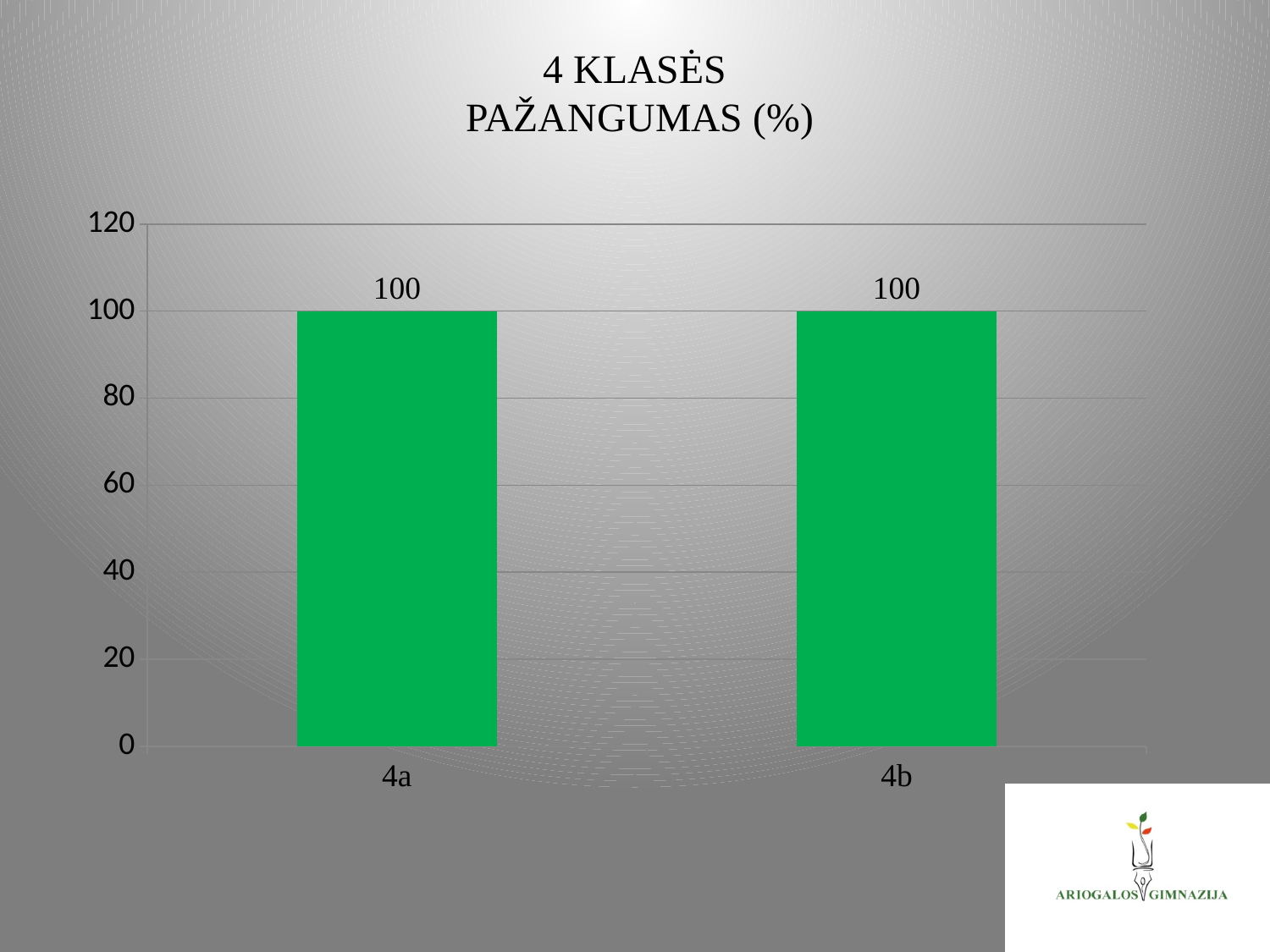
What is the value for 4b? 100 Do the values for 4a and 4b differ? No, both are 100 What kind of chart is shown on the slide? bar chart How many categories are shown on the x axis? 2 What is the difference between the values for 4a and 4b? 0 What is the title of the chart? 4 KLASĖS PAŽANGUMAS (%) What colour are the bars in the chart? green Is the value for 4a greater or less than 80? greater What is the highest value shown on the vertical axis? 120 Is the value for 4b greater or less than 120? less What is the value for 4a? 100